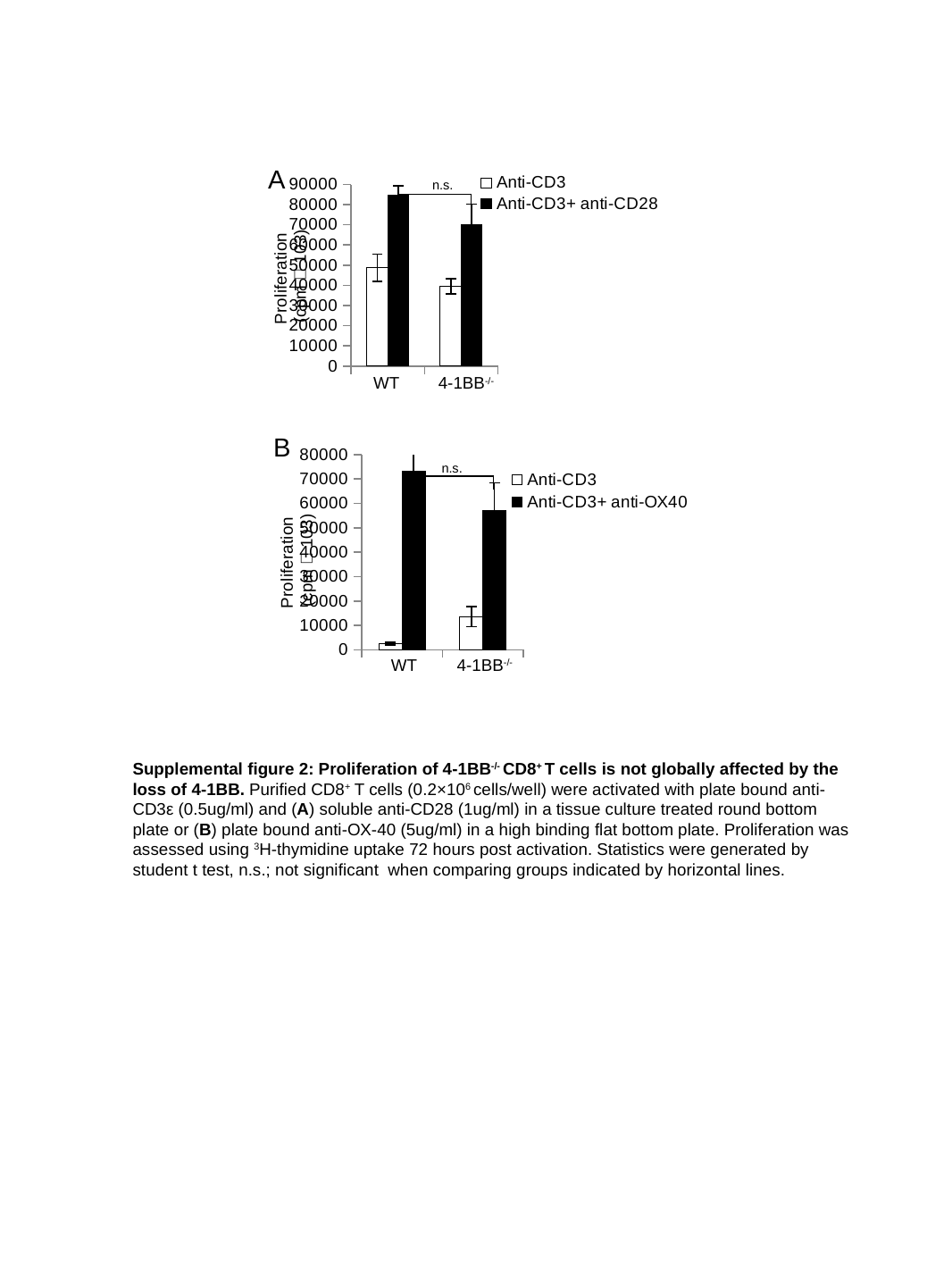
In chart A (top), is the Anti-CD3 value for 4-1BB-/- greater or less than 50000? less In chart B (bottom), how many series does the legend list? 2 In chart A (top), which is larger for WT: the Anti-CD3 bar or the Anti-CD3+ anti-CD28 bar? Anti-CD3+ anti-CD28 In chart A (top), is the Anti-CD3+ anti-CD28 value for WT greater or less than 80000? greater In chart A (top), what kind of chart is shown? bar chart In chart B (bottom), is the Anti-CD3 value for WT greater or less than 10000? less In chart A (top), how many categories are on the x axis? 2 In chart A (top), how many series does the legend list? 2 In chart A (top), which category has the lowest Anti-CD3 value? 4-1BB-/- In chart B (bottom), what is the second legend entry? Anti-CD3+ anti-OX40 In chart B (bottom), which category has the higher Anti-CD3+ anti-OX40 value? WT